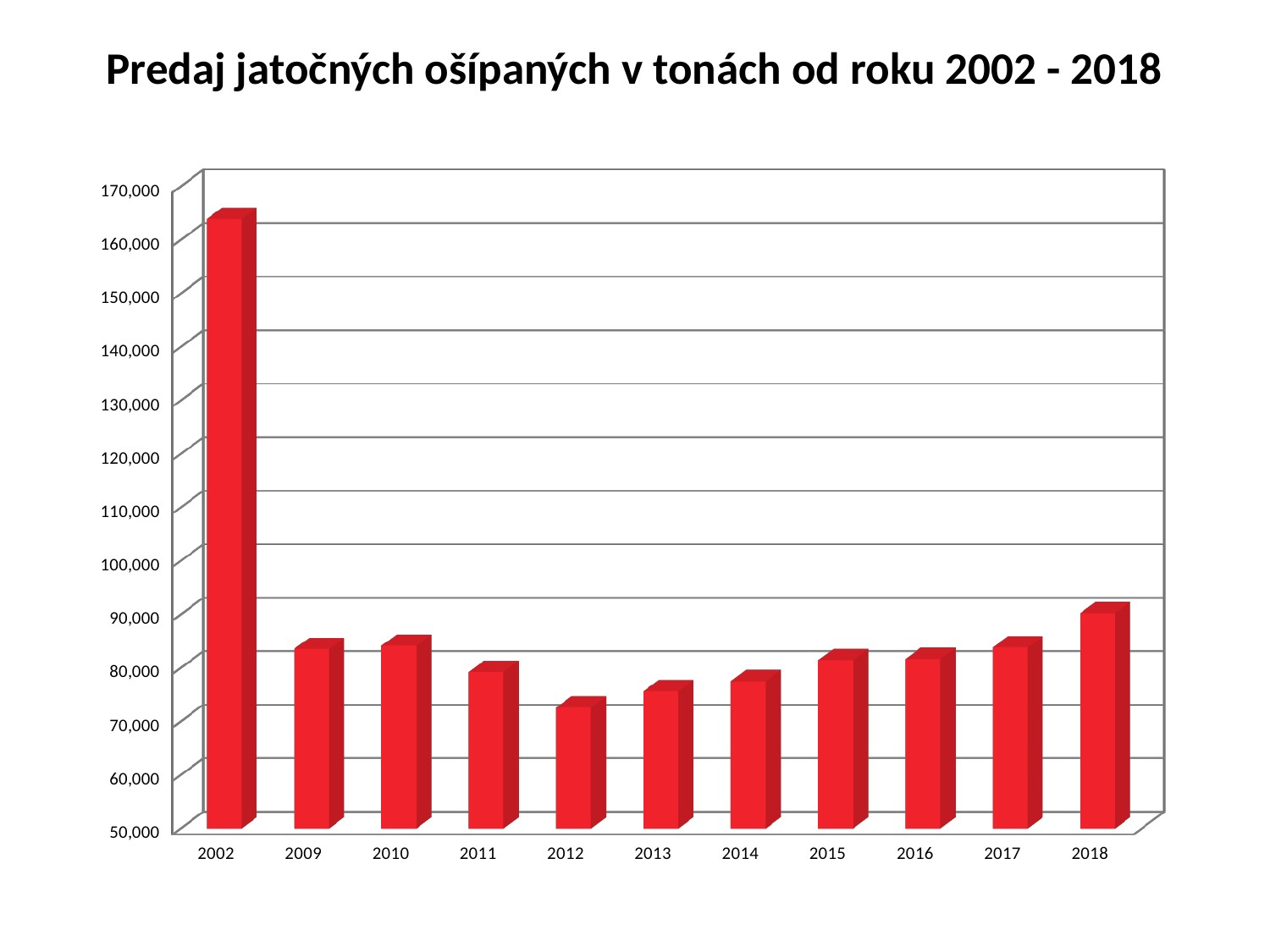
Is the value for 2012 greater or less than 80,000? less Is the value for 2002 greater or less than 150,000? greater What kind of chart is shown on the slide? bar chart Is the value for 2018 greater or less than 80,000? greater Which year has the highest value? 2002 Which year has the lowest value? 2012 What is the title of the chart? Predaj jatočných ošípaných v tonách od roku 2002 - 2018 Which is larger, the value for 2018 or the value for 2012? 2018 Do the values rise or fall from 2012 to 2018? rise How many years (bars) are shown on the x axis? 11 Which is larger, the value for 2002 or the value for 2018? 2002